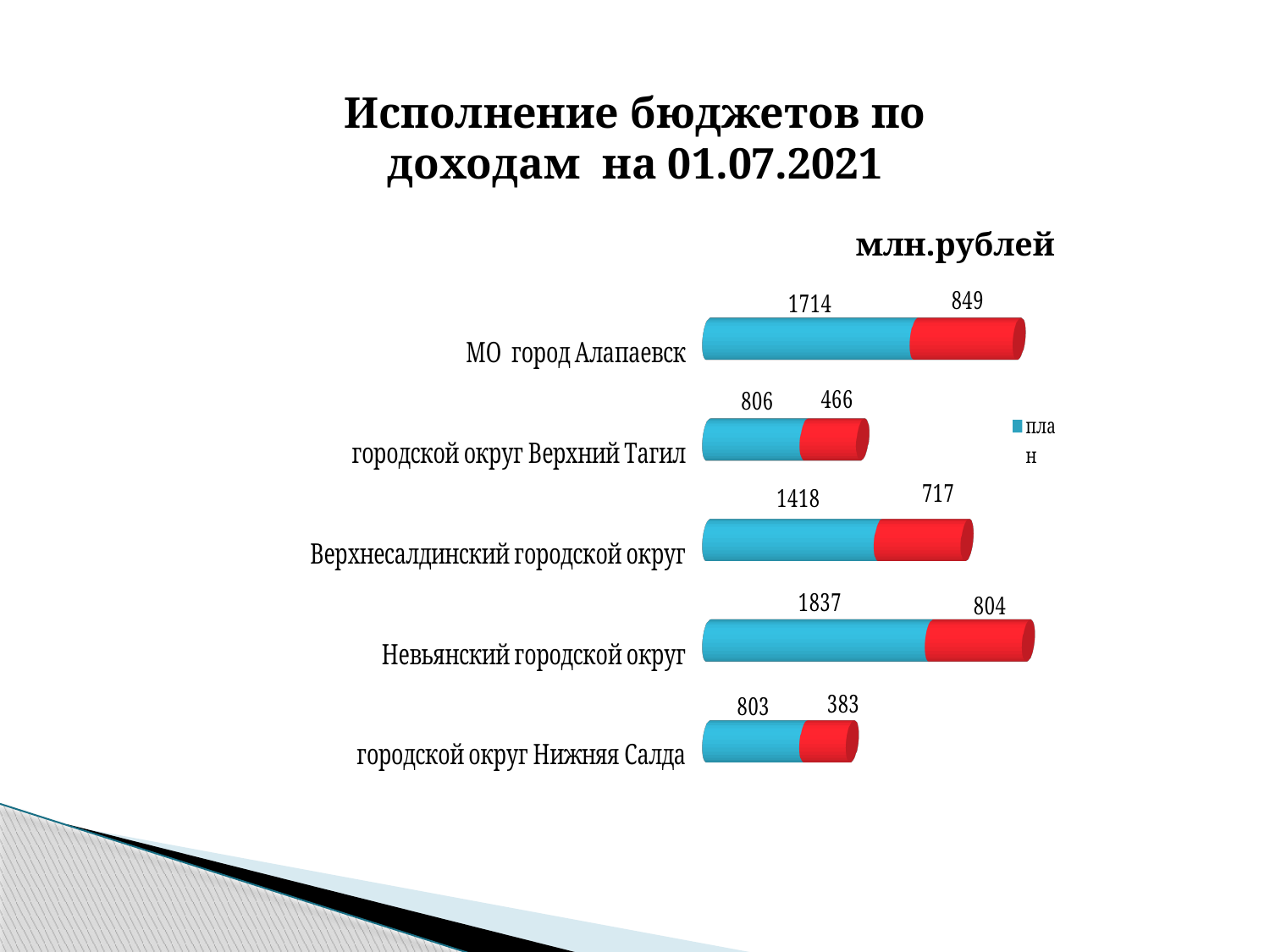
What kind of chart is shown on the slide? bar chart What is the план value for Невьянский городской округ? 1837 What is the difference between the план value and the red segment value for МО город Алапаевск? 865 How many categories are shown in the chart? 5 Which category has the lowest value in the red series? городской округ Нижняя Салда Which category has the highest план value? Невьянский городской округ Which has the larger план value: Верхнесалдинский городской округ or Невьянский городской округ? Невьянский городской округ What is the value of the red segment for городской округ Нижняя Салда? 383 What is the total of the stacked bar for Невьянский городской округ? 2641 What is the value of the red segment for МО город Алапаевск? 849 What is the план value for городской округ Верхний Тагил? 806 What unit is stated above the chart? млн.рублей